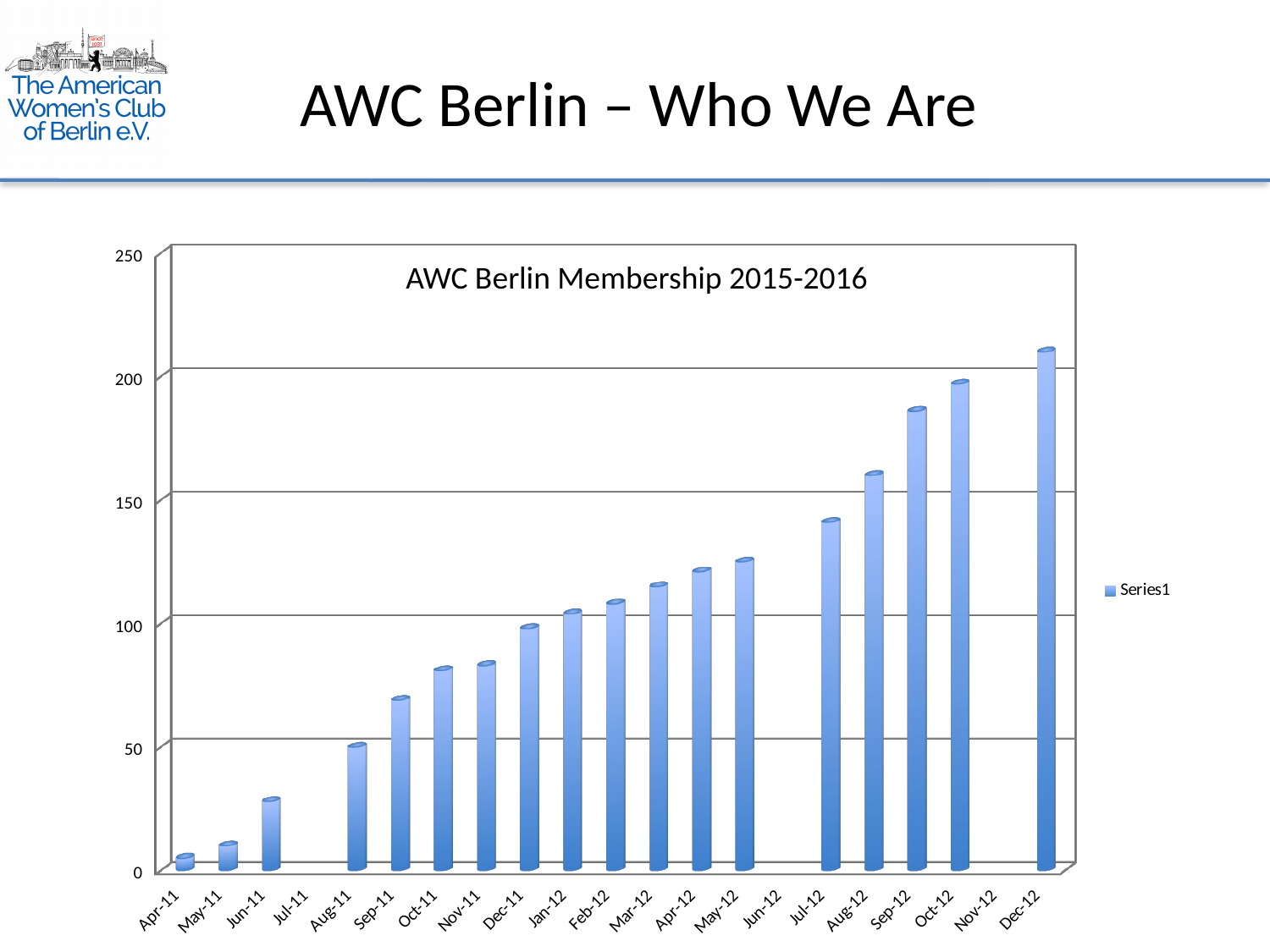
What kind of chart is shown on the slide? bar chart Do the values generally rise or fall from Apr-11 to Dec-12? rise Which month has the lowest bar among those with a visible bar? Apr-11 What is the title of the chart? AWC Berlin Membership 2015-2016 Which month has the highest bar? Dec-12 Is the value for Dec-12 greater or less than 200? greater Which is larger, the value for Sep-12 or the value for Jul-12? Sep-12 How many series does the legend list? 1 Is the value for Jun-11 greater or less than 50? less Is the value for Sep-12 greater or less than 150? greater How many month categories are shown on the x axis? 21